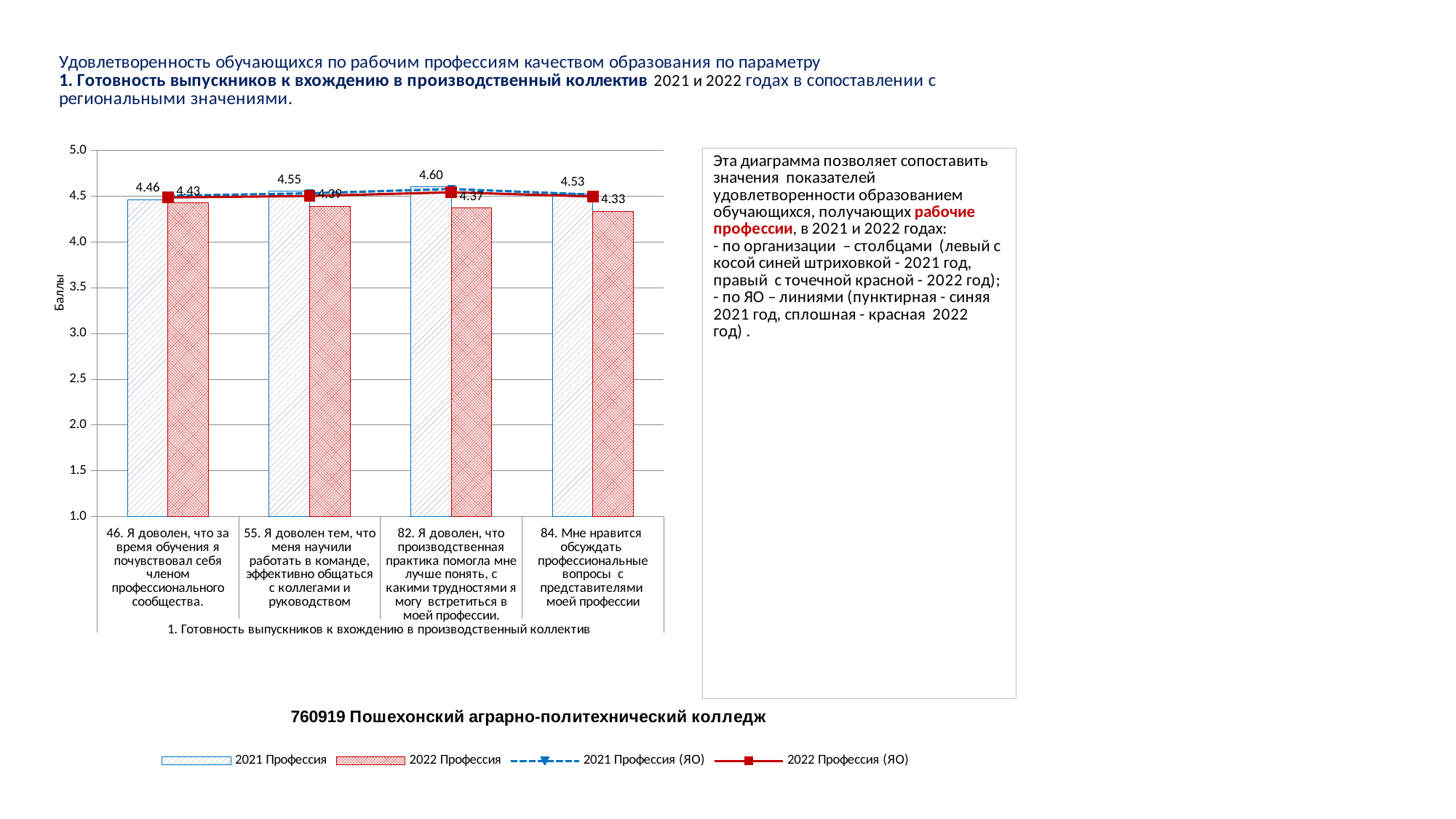
How many series does the legend list? 4 What is the difference between the 2021 Профессия and 2022 Профессия bars for category 82? 0.23 What kind of chart is this? Bar chart with line series What is the value of the 2022 Профессия bar for category 82 (производственная практика помогла мне лучше понять...)? 4.37 Which category has the highest 2021 Профессия bar? 82. Я доволен, что производственная практика помогла мне лучше понять, с какими трудностями я могу встретиться в моей профессии. For category 55, which is larger: the 2021 Профессия bar or the 2022 Профессия bar? 2021 Профессия How many categories (questions) are shown on the x axis? 4 What is the value of the 2022 Профессия bar for category 84 (Мне нравится обсуждать профессиональные вопросы...)? 4.33 Do the 2022 Профессия bar values rise or fall from category 46 to category 84? Fall Which category has the lowest 2022 Профессия bar? 84. Мне нравится обсуждать профессиональные вопросы с представителями моей профессии What is the value of the 2021 Профессия bar for category 46 (Я доволен, что за время обучения я почувствовал себя членом профессионального сообщества)? 4.46 What is the label of the y axis? Баллы